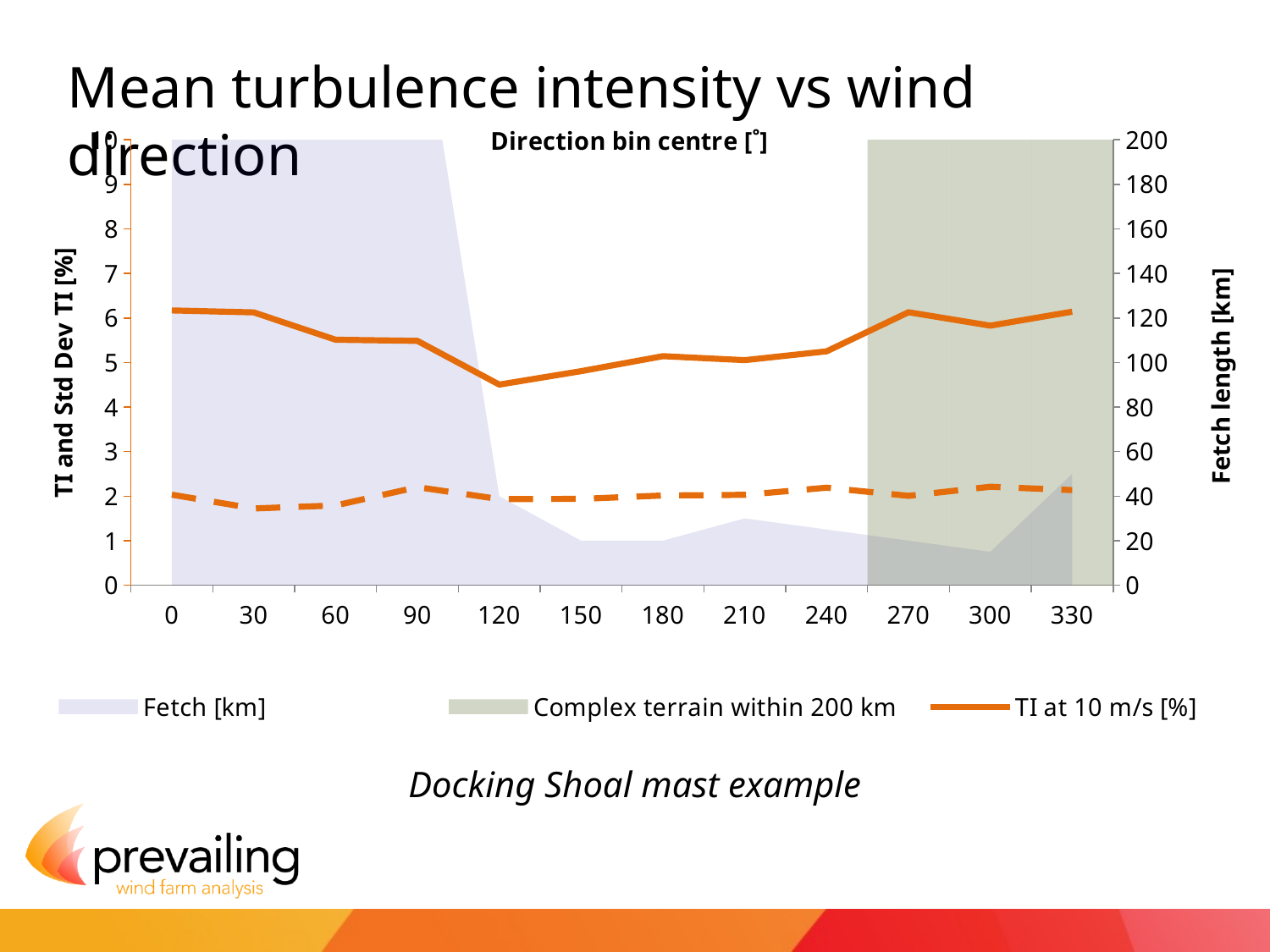
What kind of chart is shown on the slide? combination chart (shaded areas and lines) Which is larger, TI at 10 m/s [%] at direction bin 0 or at direction bin 120? direction bin 0 How many direction bin centres are shown on the x axis? 12 Is the value of TI at 10 m/s [%] at direction bin 0 greater or less than 5? greater Is the Fetch [km] value at direction bin 150 greater or less than 40? less Is the value of TI at 10 m/s [%] at direction bin 60 greater or less than 6? less Does TI at 10 m/s [%] rise or fall from direction bin 0 to direction bin 120? fall At which direction bin centre is TI at 10 m/s [%] lowest? 120 How many series does the legend list? 3 What is the title of the right-hand vertical axis? Fetch length [km]